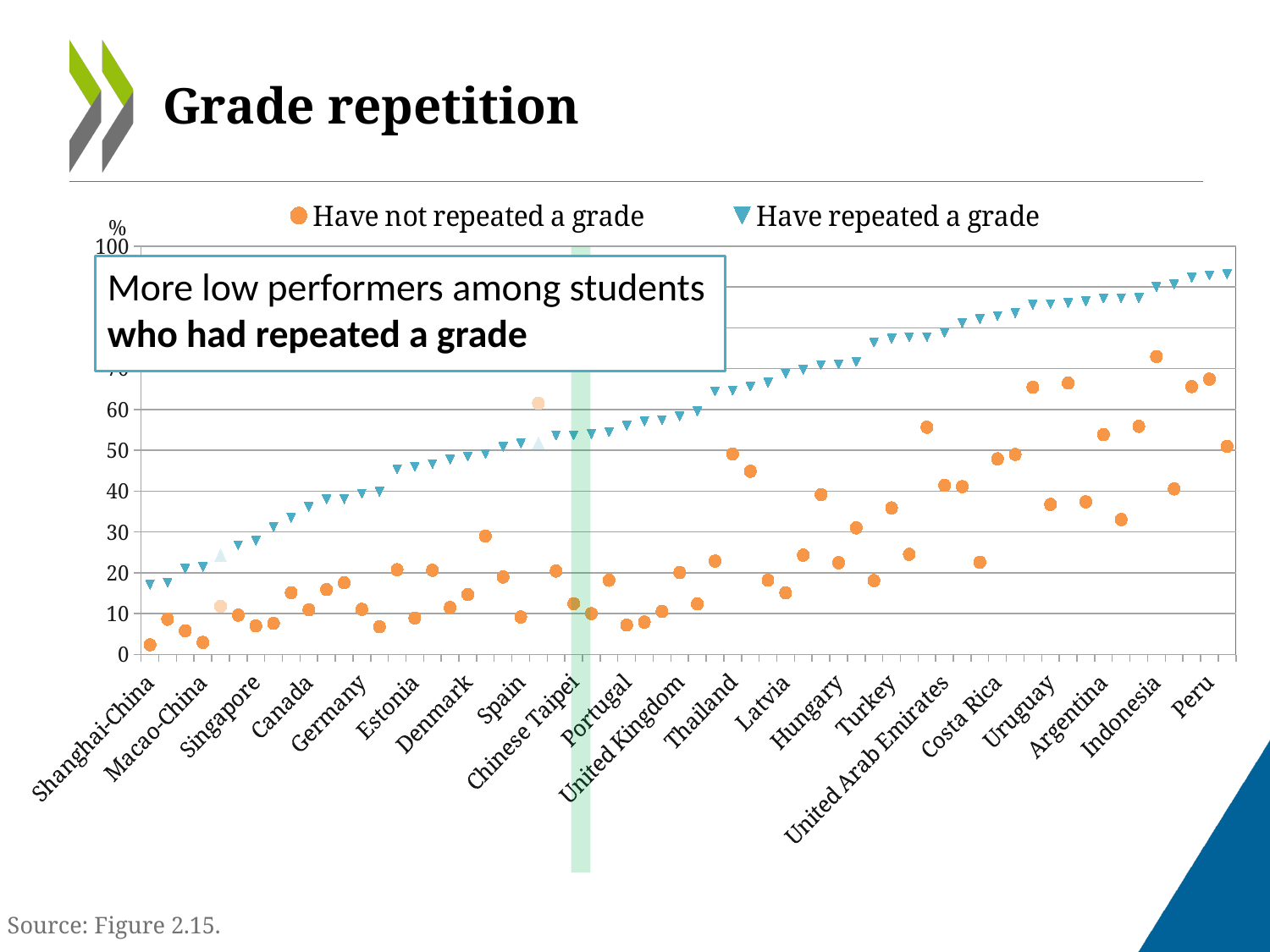
Which series is shown with blue triangle markers? Have repeated a grade What kind of chart is shown on the slide? Scatter chart How many country labels are printed along the x axis? 21 Do the values for 'Have repeated a grade' rise or fall from left to right along the x axis? Rise What is the title of the slide containing the chart? Grade repetition Which country has the lowest value for 'Have repeated a grade'? Shanghai-China Is the value for 'Have repeated a grade' in Chinese Taipei greater or less than 40? greater Is the value for 'Have not repeated a grade' in Shanghai-China greater or less than 10? less Is the value for 'Have repeated a grade' in Peru greater or less than 90? greater How many series does the legend list? 2 For Peru, which is larger: the value for 'Have repeated a grade' or 'Have not repeated a grade'? Have repeated a grade